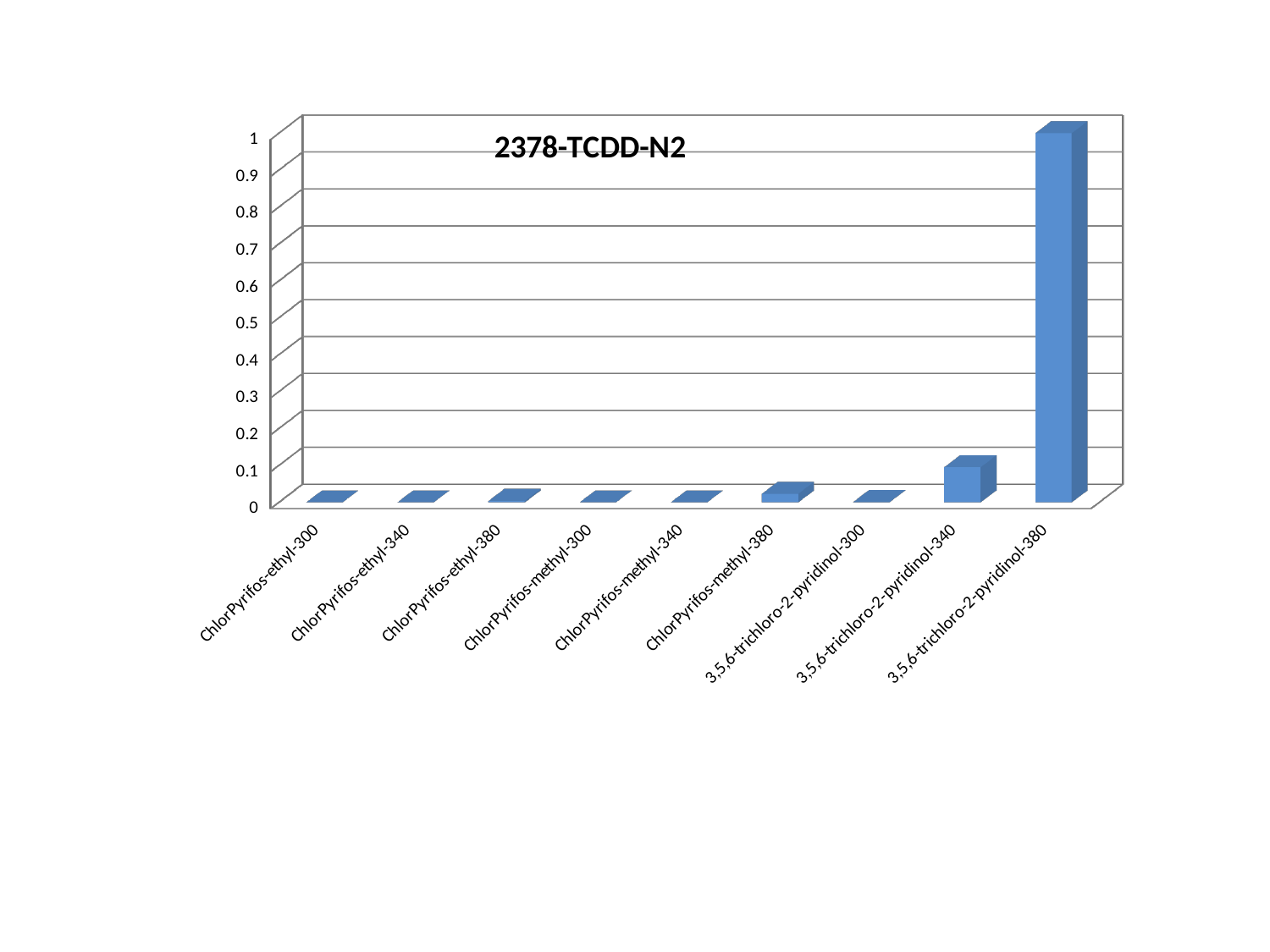
Is the value for 3,5,6-trichloro-2-pyridinol-380 greater or less than 0.9? greater What is the highest tick value shown on the vertical axis? 1 Which is larger, the value for 3,5,6-trichloro-2-pyridinol-340 or the value for ChlorPyrifos-methyl-380? 3,5,6-trichloro-2-pyridinol-340 Which is larger, the value for 3,5,6-trichloro-2-pyridinol-380 or the value for 3,5,6-trichloro-2-pyridinol-340? 3,5,6-trichloro-2-pyridinol-380 Is the value for 3,5,6-trichloro-2-pyridinol-340 greater or less than 0.2? less How many categories are plotted on the x axis? 9 Is the value for 3,5,6-trichloro-2-pyridinol-380 greater or less than 0.5? greater What kind of chart is shown on the slide? bar chart What is the title of the chart? 2378-TCDD-N2 Which category has the highest bar? 3,5,6-trichloro-2-pyridinol-380